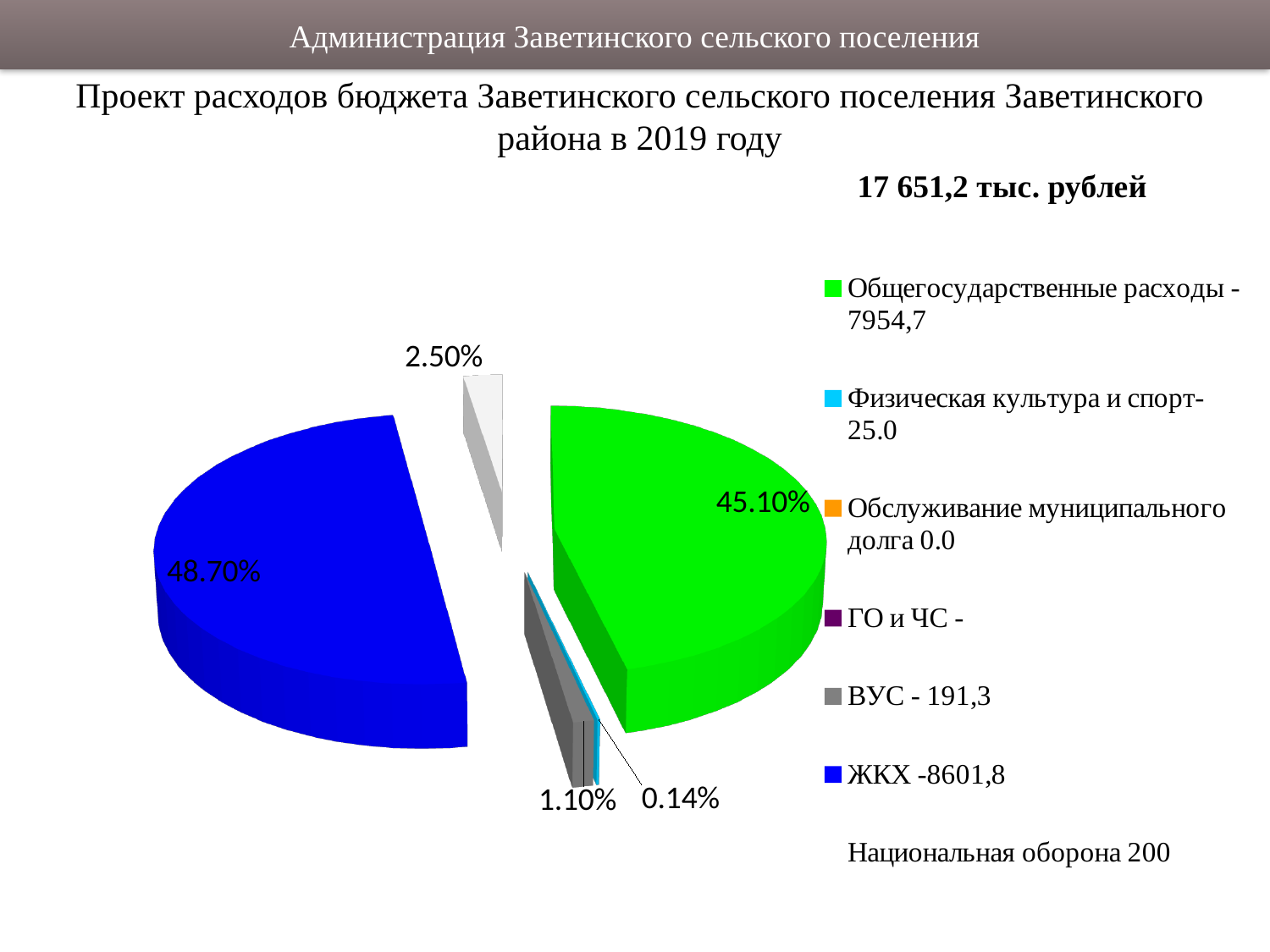
What percentage share is shown for the ВУС slice? 1.10% What amount is given in the legend for ЖКХ? 8601,8 What percentage share is shown for the Физическая культура и спорт slice? 0.14% What percentage share is shown for the ЖКХ slice? 48.70% What kind of chart is shown on the slide? pie chart What total budget amount is printed above the chart? 17 651,2 тыс. рублей What amount is given in the legend for ВУС? 191,3 What is the difference in percentage points between the ЖКХ share and the Общегосударственные расходы share? 3.60 How many entries does the chart legend list? 7 Which category has the largest share of the pie? ЖКХ Which is larger, the share for ЖКХ or the share for Общегосударственные расходы? ЖКХ